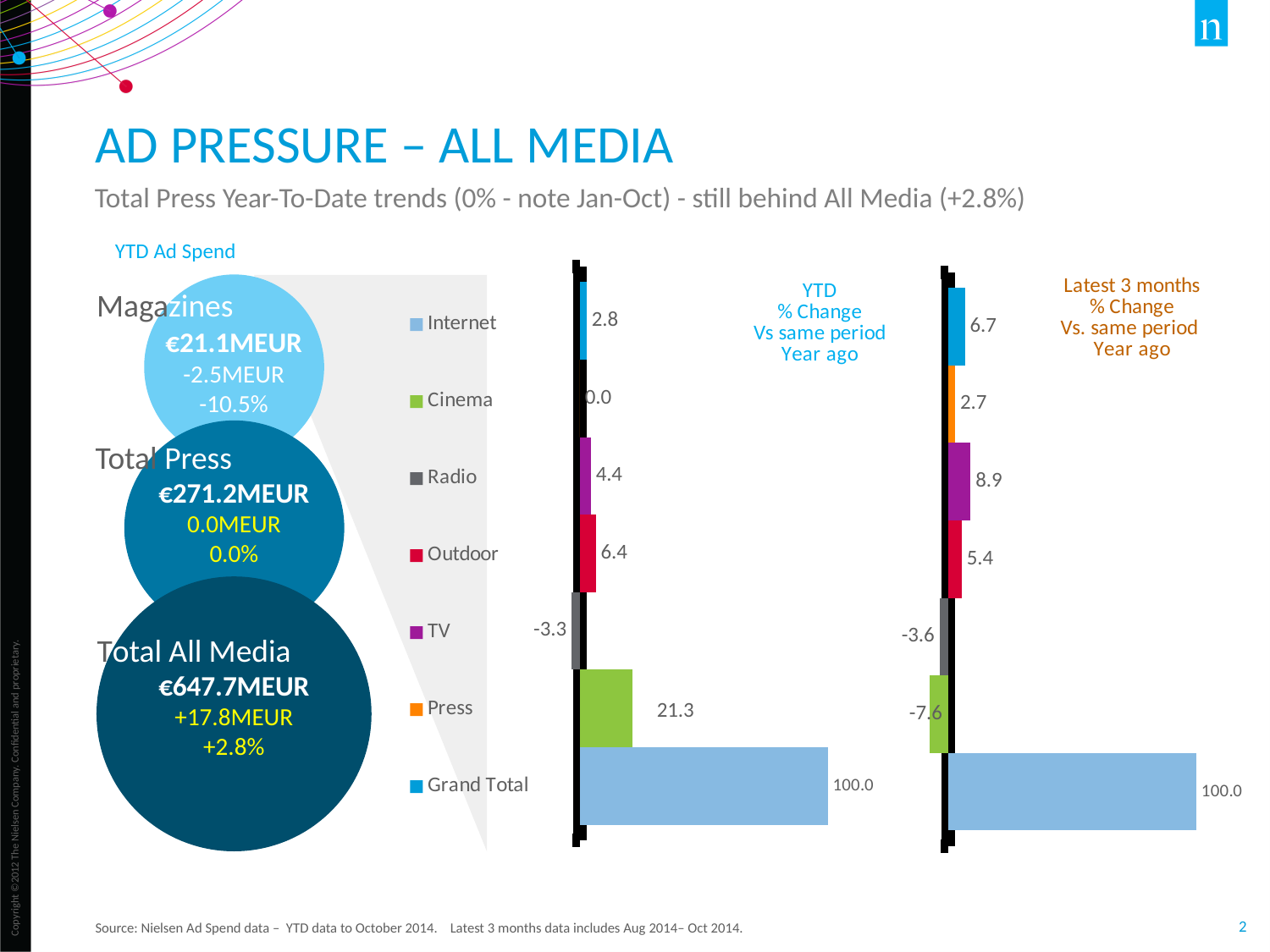
In the YTD % Change chart, what is the lowest value shown? -3.3 How many bars are plotted in the Latest 3 months % Change chart? 7 What kind of chart is the YTD % Change chart? bar chart In the YTD % Change chart, what is the value for Internet? 100.0 In the Latest 3 months % Change chart, what is the value for Internet? 100.0 In the Latest 3 months % Change chart, what is the lowest value shown? -7.6 In the YTD % Change chart, what is the difference between the Grand Total value and the Internet value? 97.2 Is the Internet value larger in the YTD % Change chart or in the Latest 3 months % Change chart? Neither; it is 100.0 in both In the Latest 3 months % Change chart, what is the value for Grand Total? 6.7 How many negative values are shown in the Latest 3 months % Change chart? 2 How many entries does the legend list for the charts? 7 In the YTD % Change chart, what is the value for Grand Total? 2.8